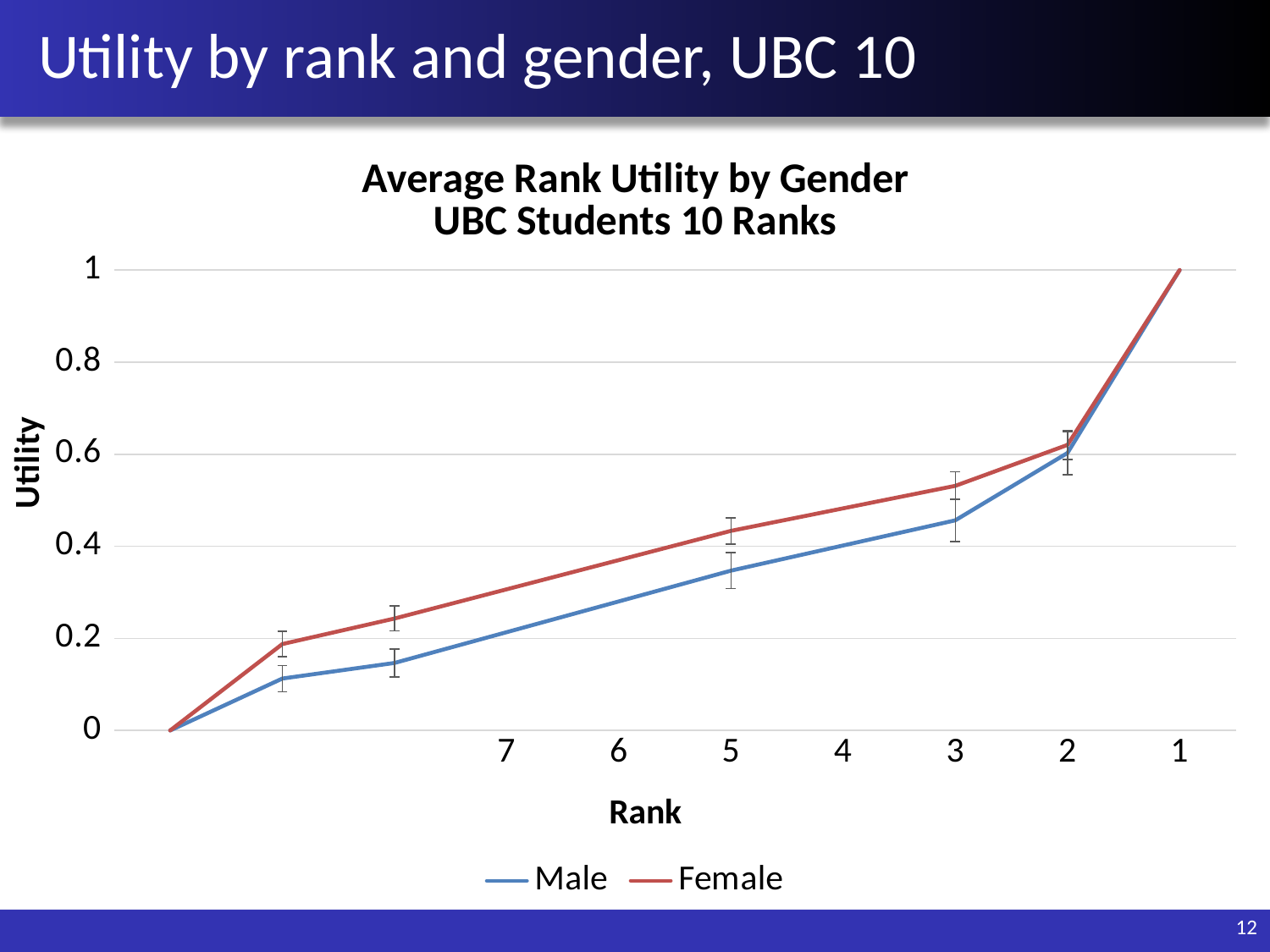
What is the Female utility at rank 1? 1 At rank 5, which series has the higher utility, Male or Female? Female What is the title of the chart? Average Rank Utility by Gender UBC Students 10 Ranks What is the Male utility at rank 1? 1 Which colour is used for the Female line? red How many series does the legend list? 2 Is the Female utility at rank 3 greater or less than 0.6? less Do the utility values rise or fall moving left to right along the x axis from rank 7 to rank 1? rise Is the Male utility at rank 5 greater or less than 0.4? less What kind of chart is shown on the slide? line chart Is the Female utility at rank 5 greater or less than 0.4? greater